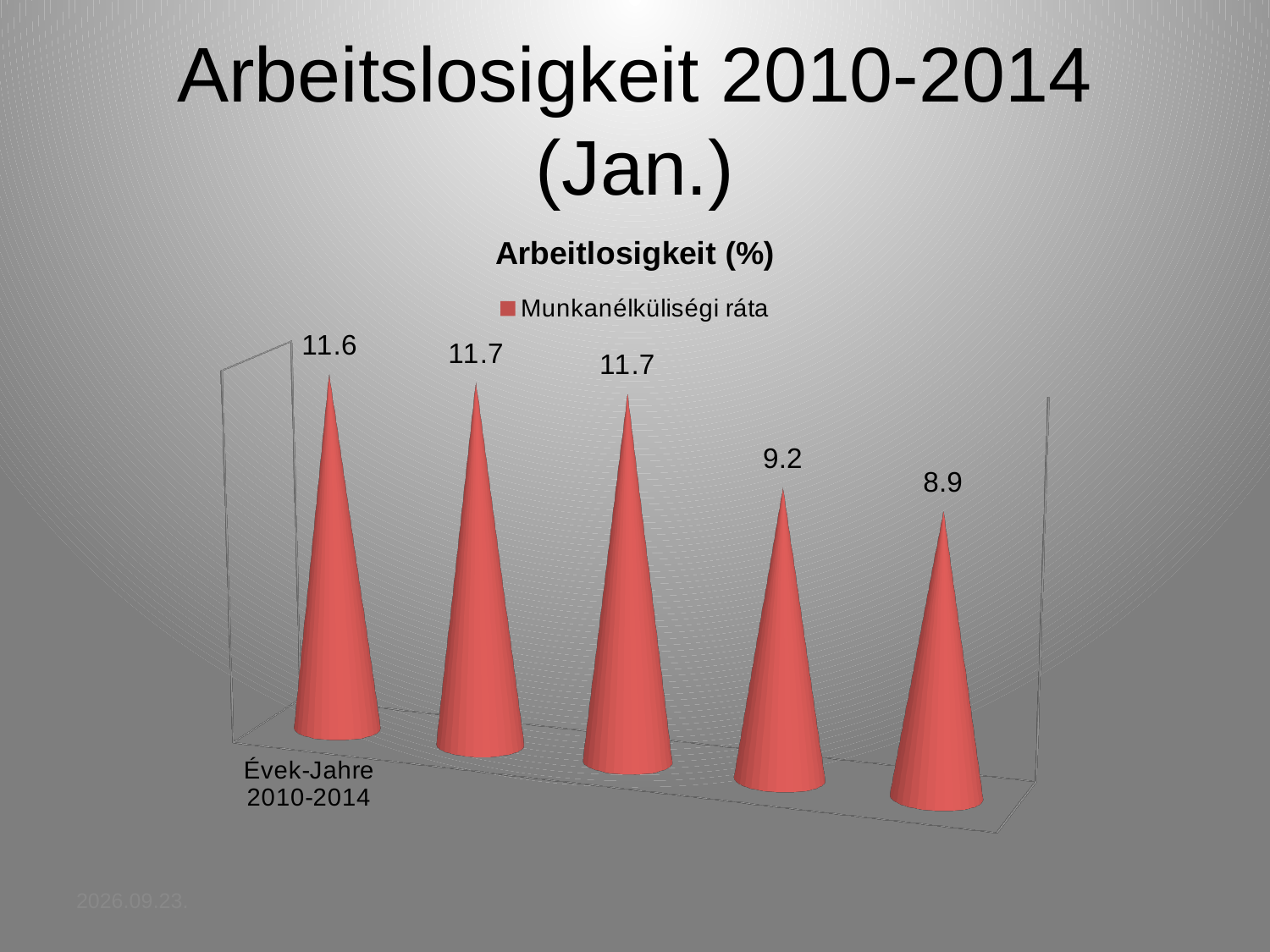
Which bar has the larger value, the leftmost bar or the rightmost bar? the leftmost bar How many bars are plotted in the chart? 5 What is the difference between the leftmost bar's value and the rightmost bar's value? 2.7 Do the values generally rise or fall from left to right across the chart? fall What is the value shown on the leftmost bar of the chart? 11.6 What kind of chart is shown on the slide? bar chart How many series does the legend list? 1 What is the value shown on the fourth bar from the left? 9.2 What is the difference between the fourth bar's value (9.2) and the fifth bar's value (8.9)? 0.3 What is the lowest value shown in the chart? 8.9 What is the value shown on the rightmost bar of the chart? 8.9 What is the name of the series listed in the chart legend? Munkanélküliségi ráta